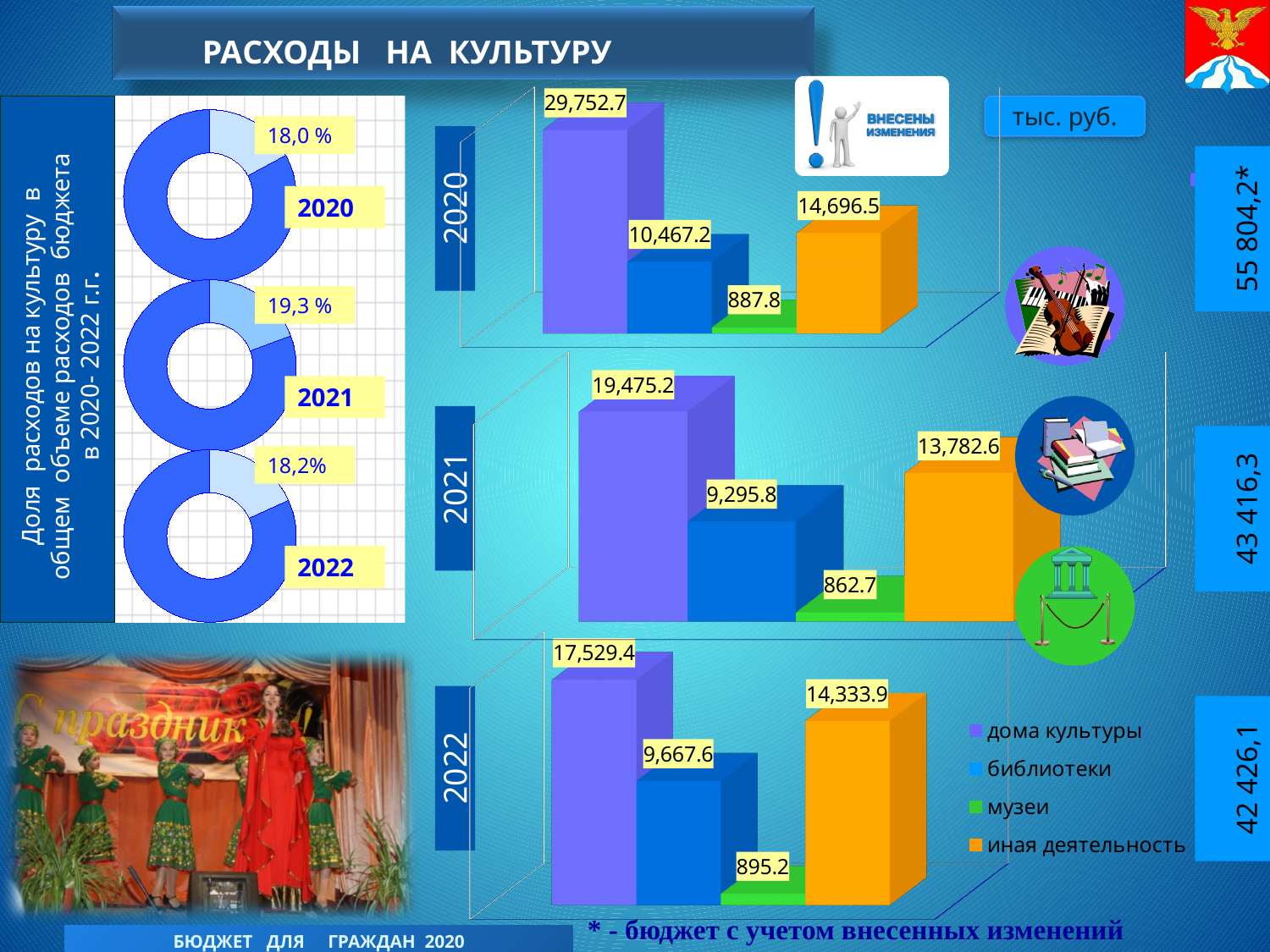
In the 2022 bar chart, what is the value for иная деятельность? 14,333.9 How many series does the legend of the bar charts list? 4 How do the values for дома культуры change from the 2020 chart to the 2022 chart? fall In the 2022 bar chart, what is the value for музеи? 895.2 In the donut chart for 2021, what share of total budget expenses goes to culture? 19,3 % In the 2021 bar chart, what is the value for библиотеки? 9,295.8 In the 2020 bar chart, what is the difference between дома культуры and иная деятельность? 15,056.2 In the 2020 bar chart, what is the value for дома культуры? 29,752.7 What type of chart is used to show the 2020, 2021 and 2022 expenditure breakdowns? bar chart In the 2020 bar chart, which category has the lowest value? музеи In the 2022 bar chart, which is larger: библиотеки or иная деятельность? иная деятельность In the 2021 bar chart, which category has the highest value? дома культуры